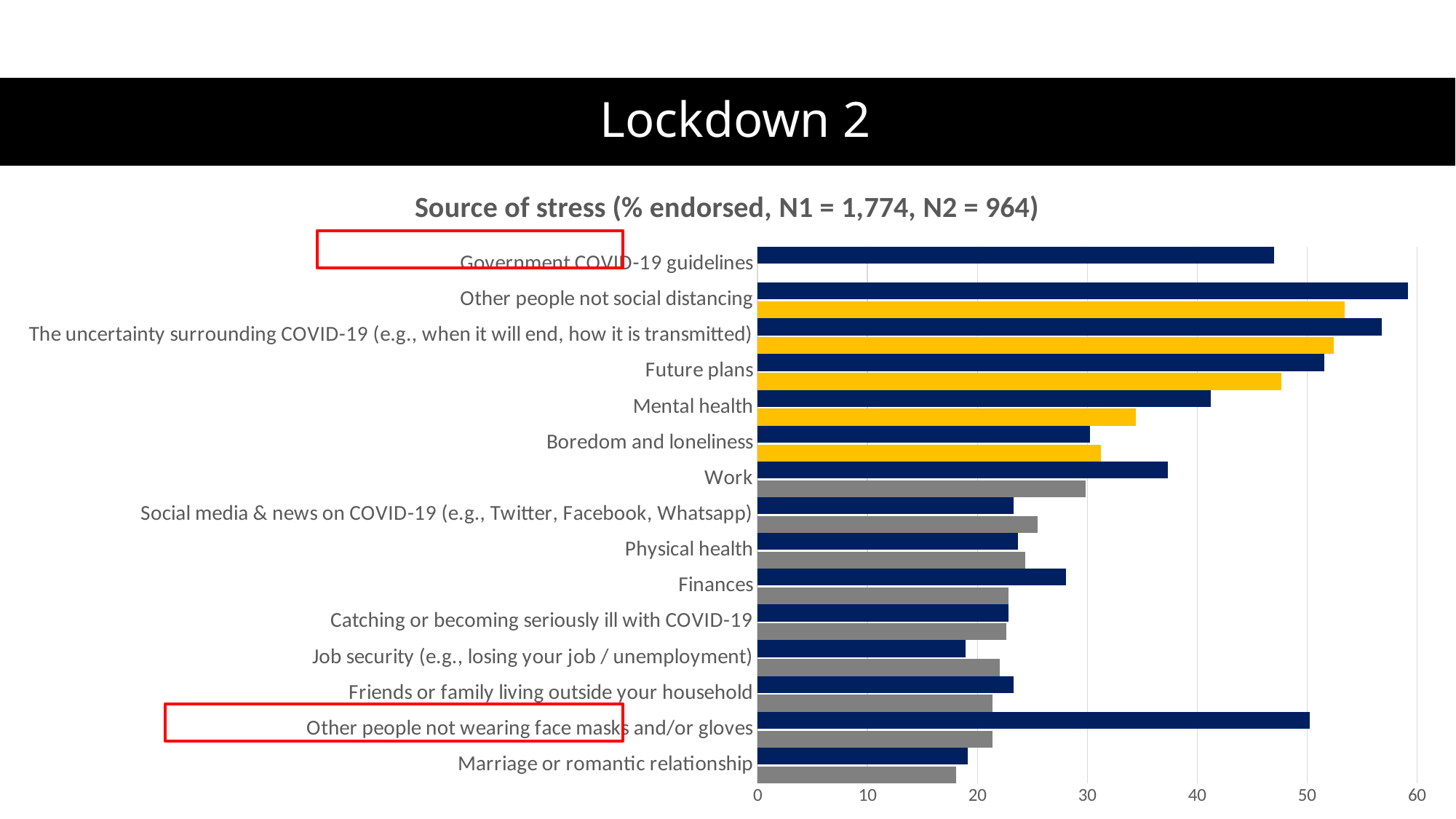
What is the title of the chart? Source of stress (% endorsed, N1 = 1,774, N2 = 964) Is the dark blue bar for Other people not wearing face masks and/or gloves greater or less than 40? greater Is the dark blue bar for The uncertainty surrounding COVID-19 greater or less than 50? greater How many stress-source categories are listed on the chart's vertical axis? 15 Is the dark blue bar for Finances greater or less than 30? less What kind of chart is shown on the slide? bar chart Which has the longer dark blue bar, Work or Finances? Work Which has the longer dark blue bar, Future plans or Mental health? Future plans Which category has the longest bar on the chart? Other people not social distancing What is the highest value shown on the horizontal axis? 60